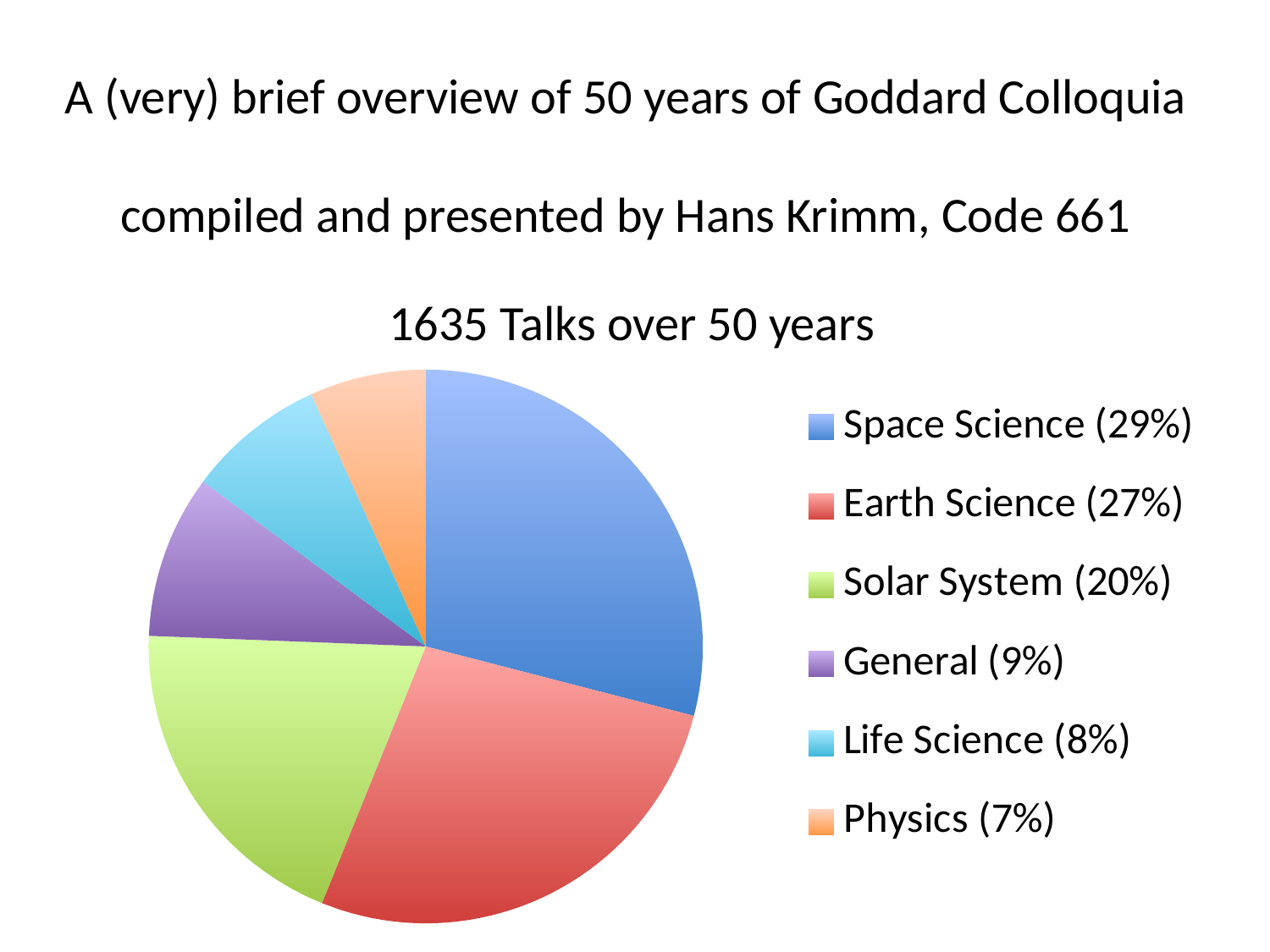
What share of the pie does Space Science have? 29% What is the title of the pie chart? 1635 Talks over 50 years Which category has the largest share of the pie? Space Science What share of the pie does Solar System have? 20% How many slices does the pie chart have? 6 What share of the pie does Physics have? 7% Which category has the smallest share of the pie? Physics What is the difference in percentage points between Space Science and Earth Science? 2 What colour is the Earth Science slice? red Which has a larger share, Life Science or General? General What is the difference in percentage points between Solar System and General? 11 What kind of chart is shown on the slide? pie chart